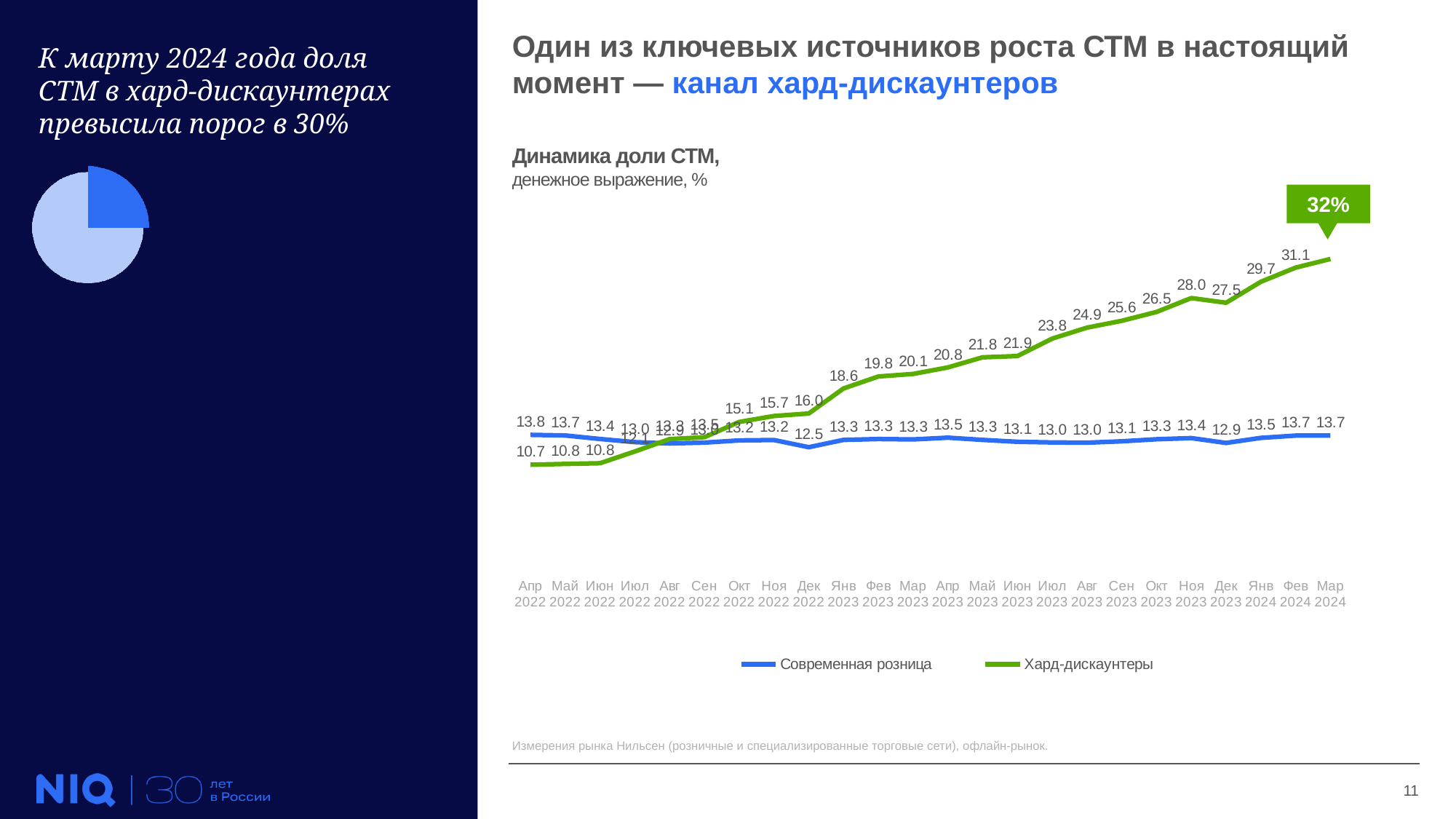
What is the value for Современная розница in Мар 2024? 13.7 What is the difference between the Хард-дискаунтеры values for Фев 2024 and Янв 2024? 1.4 What kind of chart is shown under the title "Динамика доли СТМ"? line chart In Апр 2022, which series has the higher value: Современная розница or Хард-дискаунтеры? Современная розница In which month does Современная розница have its lowest value? Дек 2022 What is the value for Хард-дискаунтеры in Апр 2022? 10.7 How many series does the legend of the "Динамика доли СТМ" chart list? 2 What is the value for Хард-дискаунтеры in Мар 2024? 32% What is the difference between the Хард-дискаунтеры values for Ноя 2023 and Дек 2023? 0.5 What is the value for Хард-дискаунтеры in Янв 2023? 18.6 Does the Хард-дискаунтеры line rise or fall from Апр 2022 to Мар 2024? rise What colour is the Хард-дискаунтеры line in the legend? green